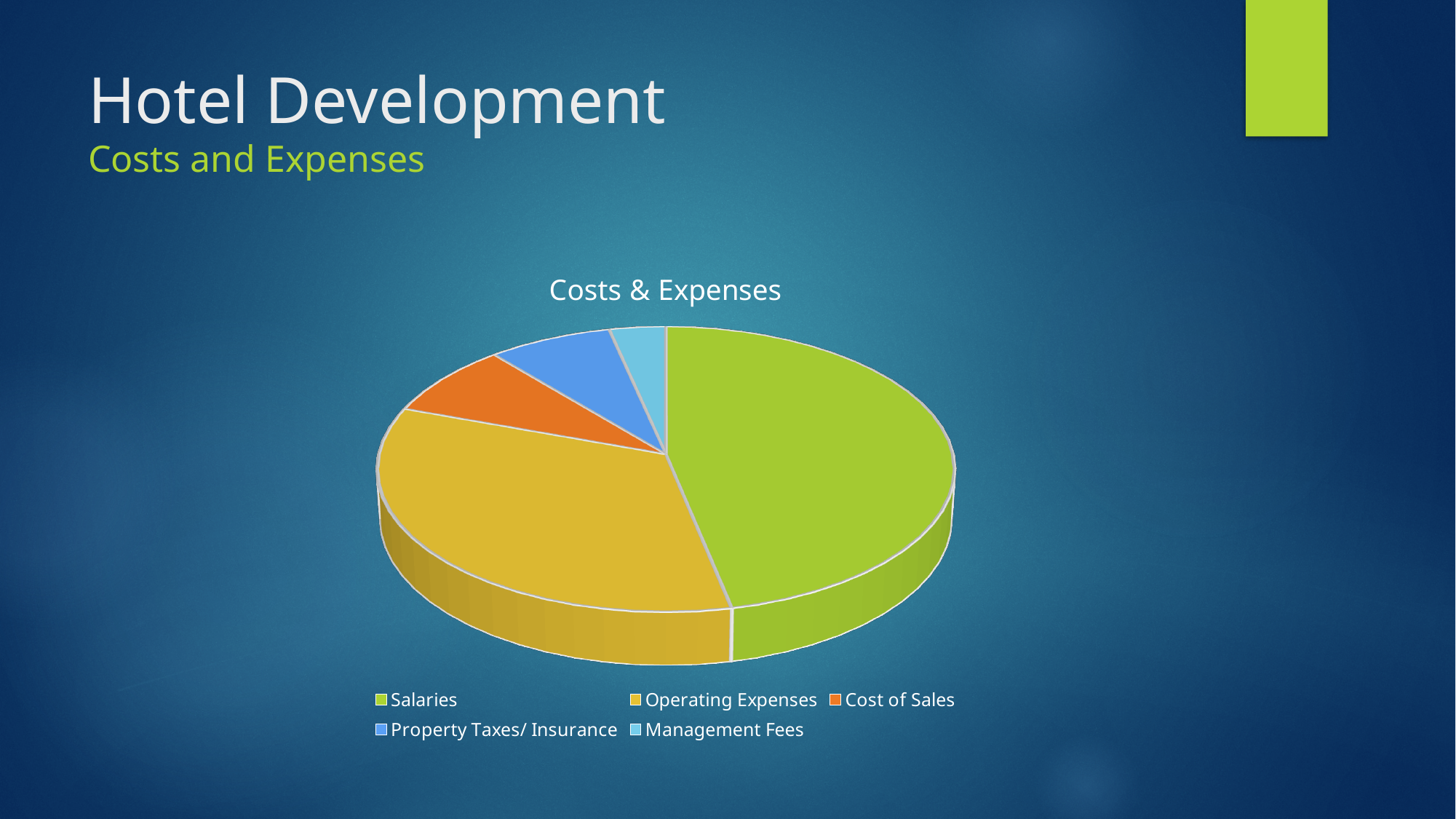
Which slice is larger, Property Taxes/ Insurance or Management Fees? Property Taxes/ Insurance Which category is shown in green in the pie chart? Salaries Which slice is larger, Operating Expenses or Cost of Sales? Operating Expenses How many categories does the pie chart show? 5 What kind of chart is shown on the slide? Pie chart Which category has the second-largest slice of the pie? Operating Expenses Which slice is larger, Cost of Sales or Management Fees? Cost of Sales Which category has the largest slice of the pie? Salaries Which category has the smallest slice of the pie? Management Fees What is the title of the chart? Costs & Expenses